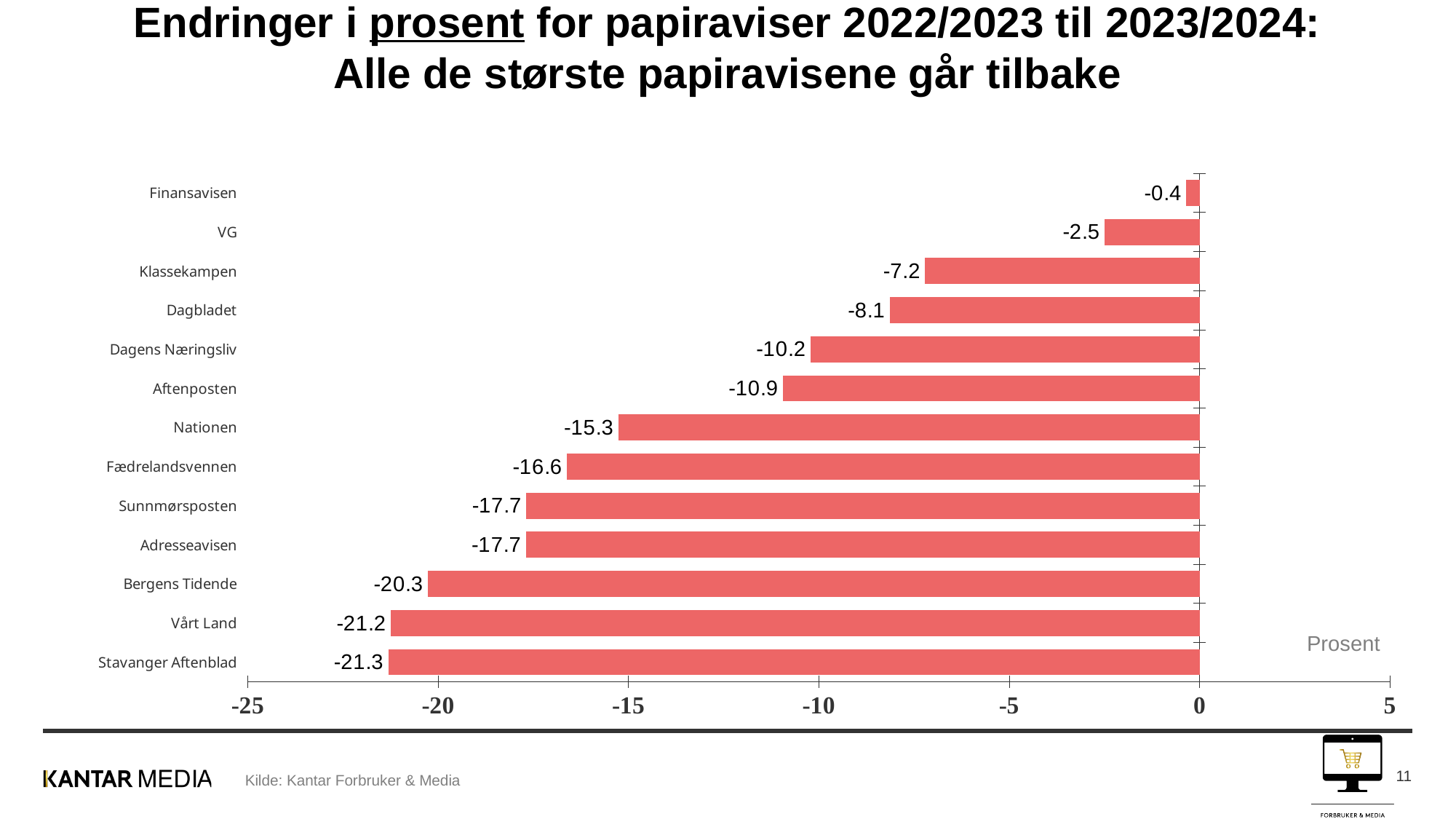
What is the difference between the values for VG and Finansavisen? 2.1 Which has a larger decline, Nationen or Fædrelandsvennen? Fædrelandsvennen Which newspaper has the largest decline (the lowest value) in the chart? Stavanger Aftenblad What label is shown on the horizontal axis of the chart? Prosent Is the value for Dagbladet greater or less than -10? greater How many newspapers are shown in the chart? 13 What is the value for Bergens Tidende? -20.3 Which newspaper has the smallest decline (the highest value) in the chart? Finansavisen What kind of chart is shown on the slide? Bar chart What is the percentage change shown for Aftenposten? -10.9 What value is shown for Klassekampen? -7.2 What is the difference between the values for Dagens Næringsliv and Aftenposten? 0.7